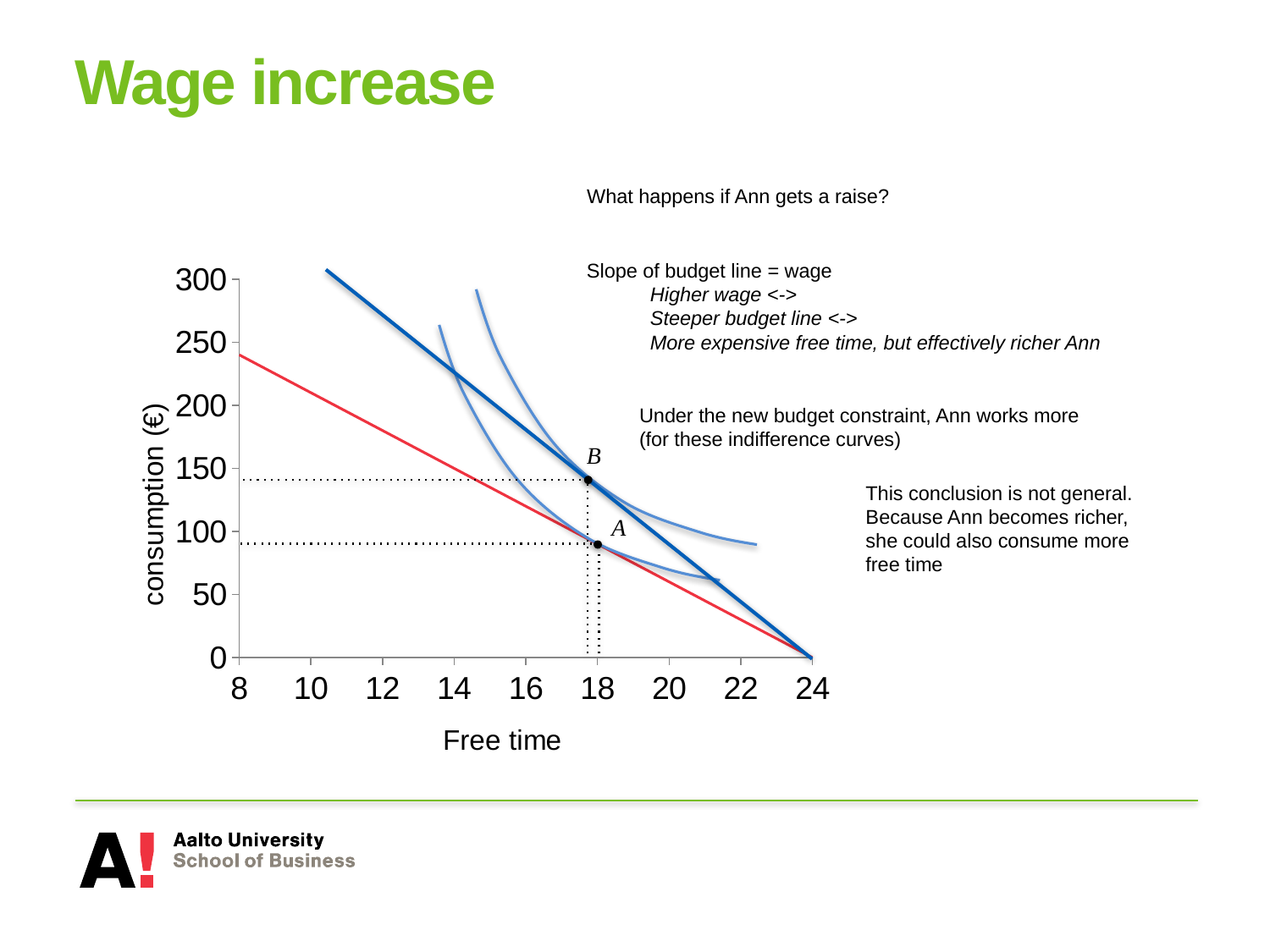
Is the consumption value at point B greater or less than 100? greater What is the label of the horizontal axis of the chart? Free time At what value of free time do both budget lines reach zero consumption? 24 Which budget line is steeper, the blue one or the red one? the blue one How many labelled points are marked on the chart? 2 Which point has the higher consumption, A or B? B Is the consumption value at point A greater or less than 100? less How much free time does point A correspond to on the chart? 18 What kind of chart is shown on the slide? line chart Do the budget lines rise or fall as free time increases? fall What is the label of the vertical axis of the chart? consumption (€) Is the consumption value at point B greater or less than 150? less